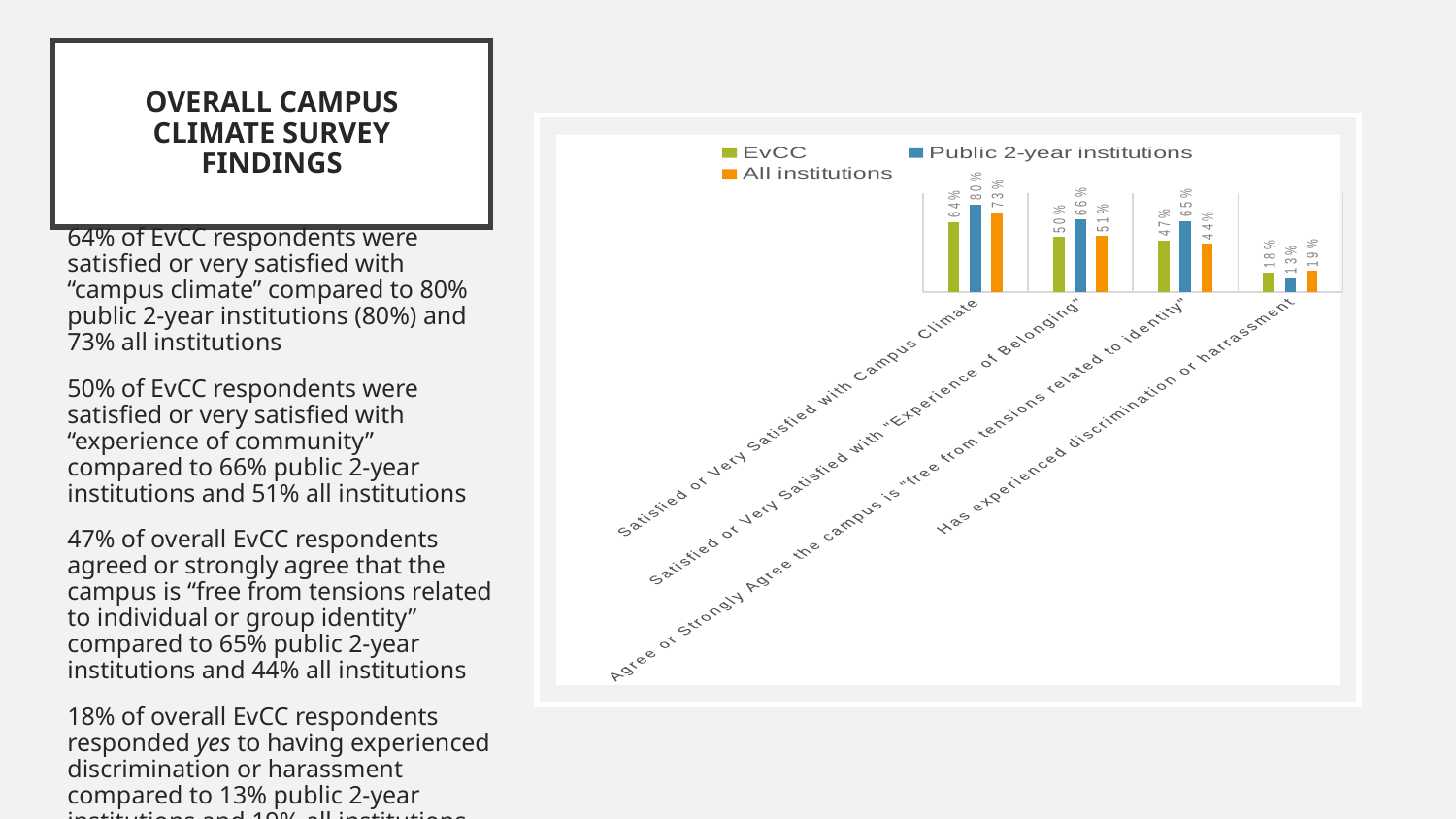
Which category has the highest EvCC value? Satisfied or Very Satisfied with Campus Climate How many series does the chart legend list? 3 How many categories are shown on the x axis of the chart? 4 Which series is shown in orange in the chart legend? All institutions What is the EvCC value for "Satisfied or Very Satisfied with Campus Climate"? 64% Which category has the lowest All institutions value? Has experienced discrimination or harrassment What is the Public 2-year institutions value for "Has experienced discrimination or harrassment"? 13% For "Has experienced discrimination or harrassment", which is larger: the EvCC value or the All institutions value? All institutions What is the difference between the Public 2-year institutions value and the EvCC value for "Satisfied or Very Satisfied with Campus Climate"? 16% What is the Public 2-year institutions value for "Satisfied or Very Satisfied with 'Experience of Belonging'"? 66% What kind of chart is shown on the slide? bar chart What is the All institutions value for "Agree or Strongly Agree the campus is 'free from tensions related to identity'"? 44%